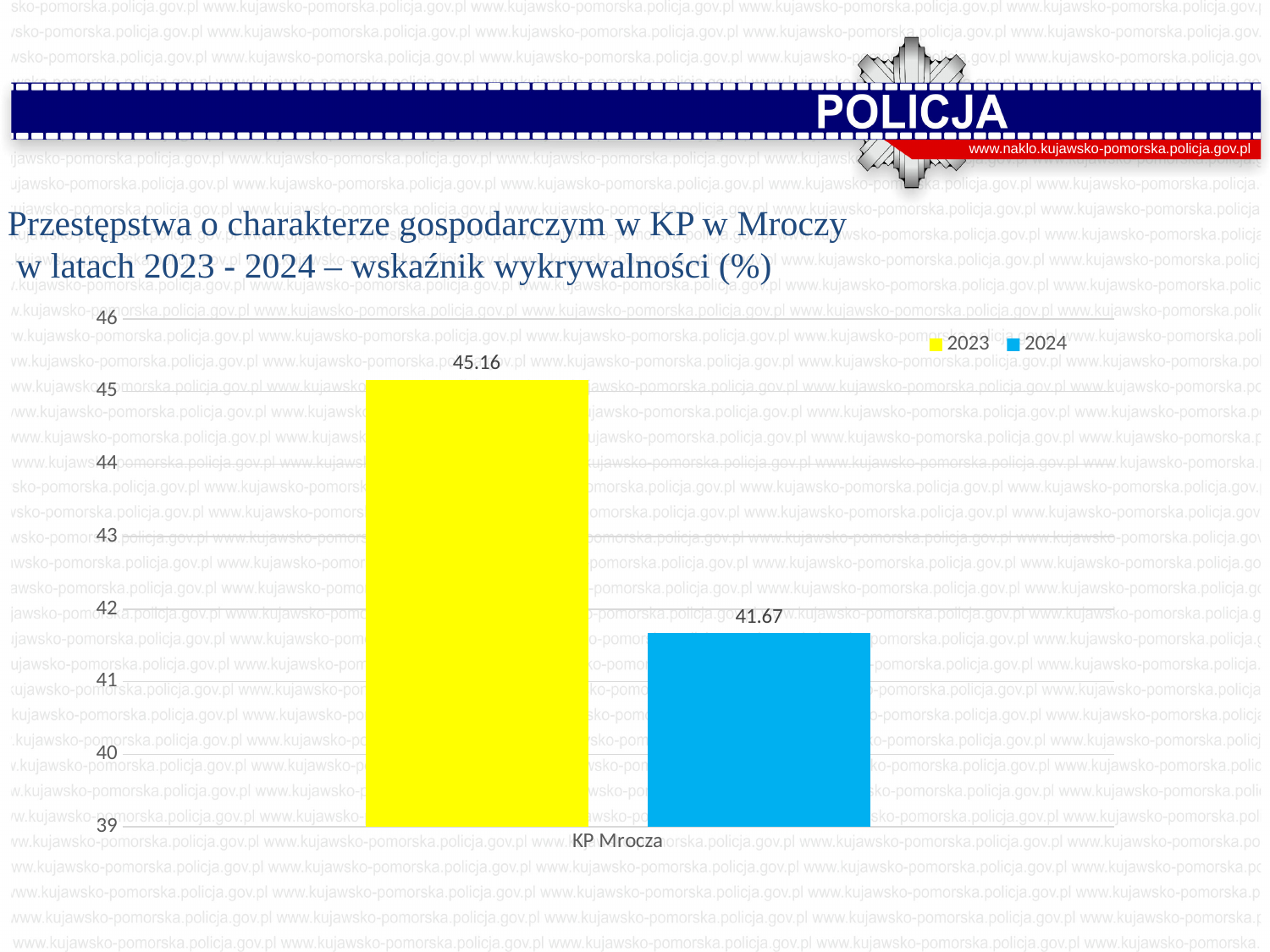
How many categories are shown on the x axis? 1 Which year has the higher detection rate, 2023 or 2024? 2023 How many series does the legend list? 2 What is the detection rate for 2023 for KP Mrocza? 45.16 What is the difference between the 2023 and 2024 detection rates? 3.49 Is the value for 2023 greater or less than 45? greater Which series has the lowest value on the chart? 2024 Which colour represents 2024 in the legend? blue Is the value for 2024 greater or less than 42? less What is the category label on the x axis? KP Mrocza What is the detection rate for 2024 for KP Mrocza? 41.67 What kind of chart is shown on the slide? bar chart